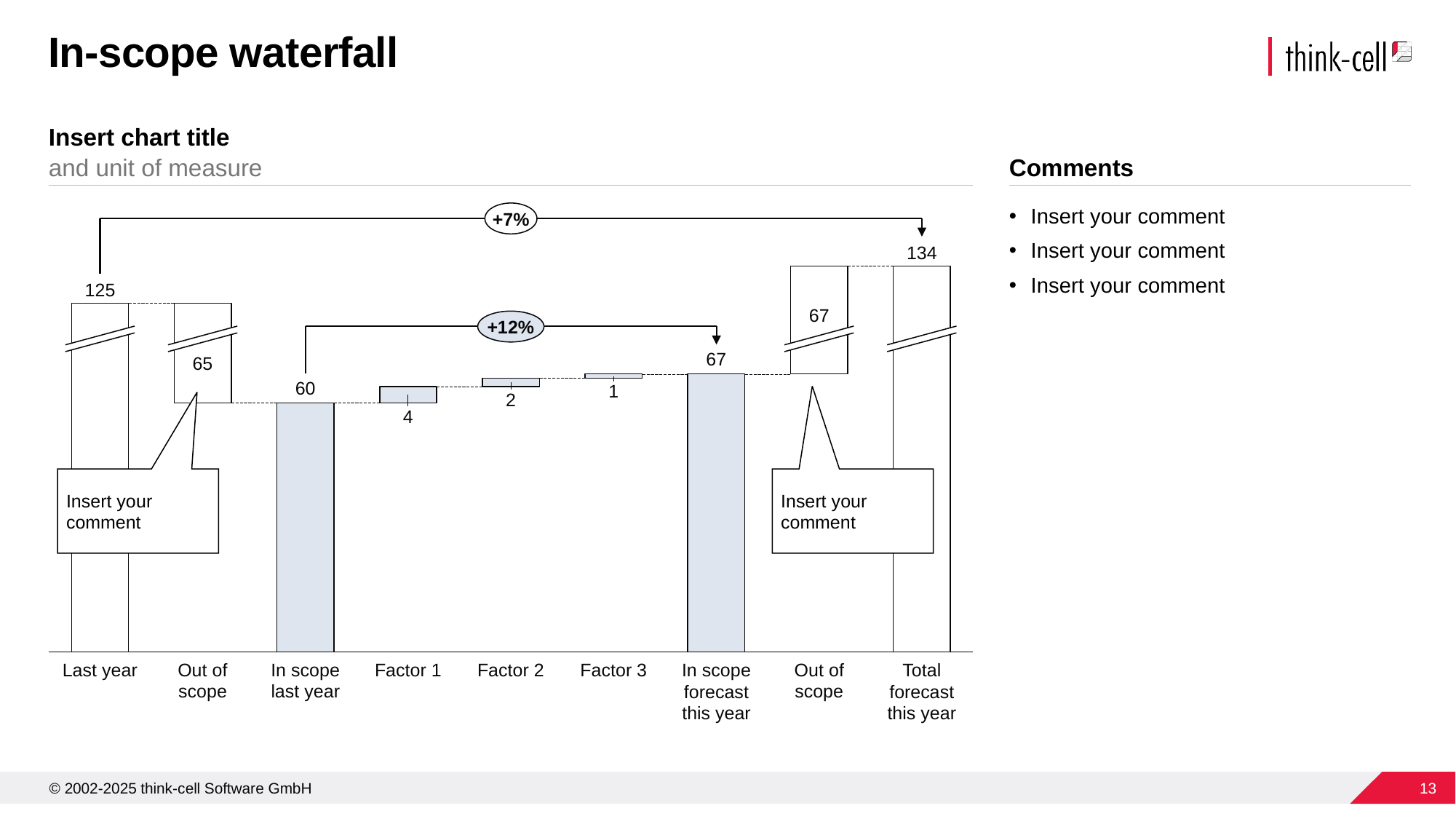
Which category has the highest value in the chart? Total forecast this year What is the value for In scope last year? 60 What is the value for Last year? 125 What is the value for In scope forecast this year? 67 What is the value of the first Out of scope bar, next to Last year? 65 Which is larger, the value for Factor 1 or the value for Factor 2? Factor 1 Which of the three factors (Factor 1, Factor 2, Factor 3) has the smallest value? Factor 3 How many categories are shown on the x axis? 9 What percentage change is shown by the arrow from In scope last year to In scope forecast this year? +12% What is the value for Factor 1? 4 What is the value for Total forecast this year? 134 What is the difference between Total forecast this year and Last year? 9